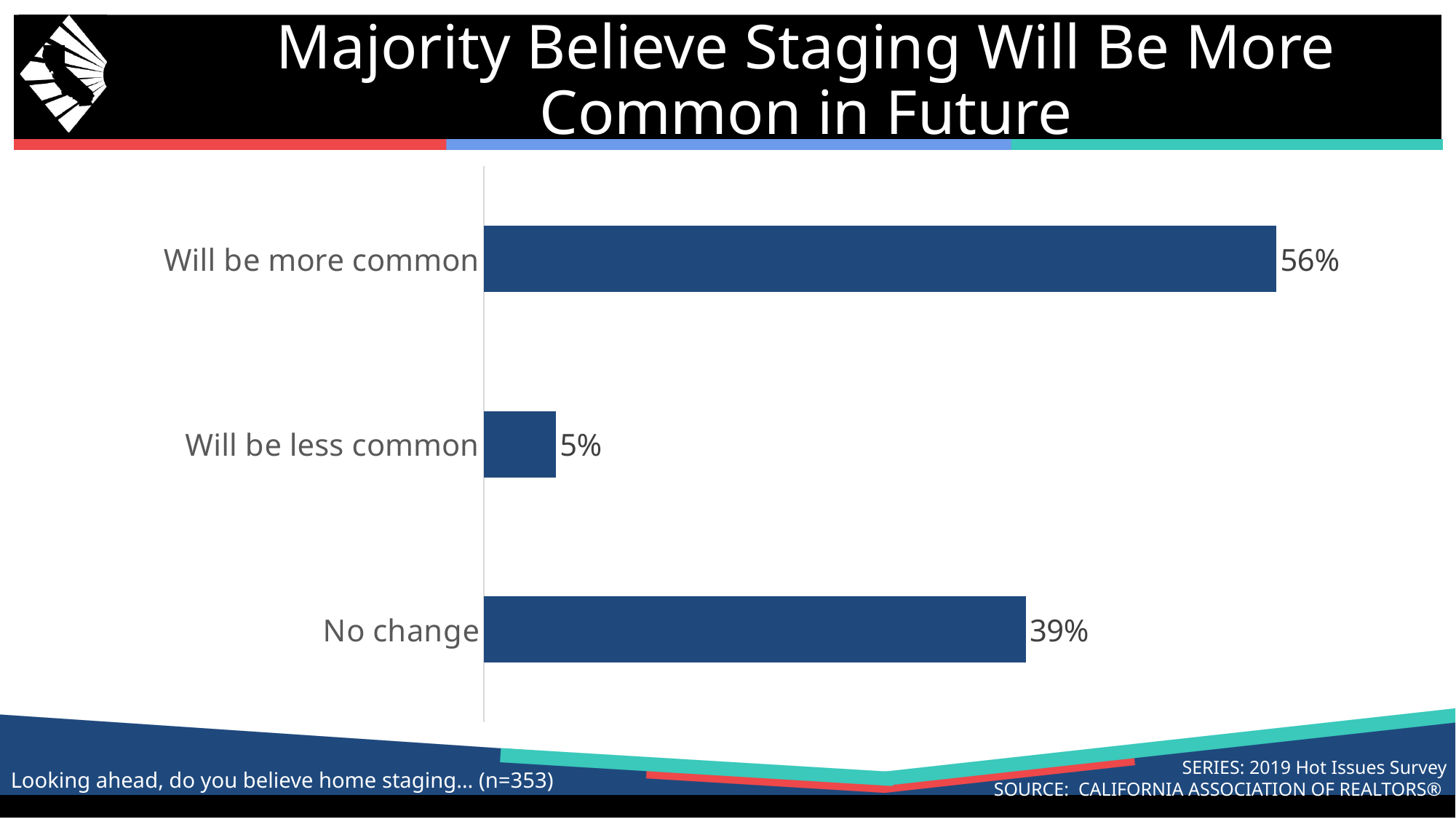
What is the sample size (n) given for the survey question? 353 What percentage of respondents believe staging will be less common? 5% What is the difference between the 'Will be more common' and 'No change' values? 17% How many categories are shown in the chart? 3 What percentage of respondents believe there will be no change in staging? 39% What kind of chart is shown on the slide? Bar chart What percentage of respondents believe staging will be more common? 56% What is the difference between the 'No change' and 'Will be less common' values? 34% Which category has the lowest value? Will be less common Which is larger: 'No change' or 'Will be less common'? No change Which category has the highest value? Will be more common What is the title of the slide? Majority Believe Staging Will Be More Common in Future